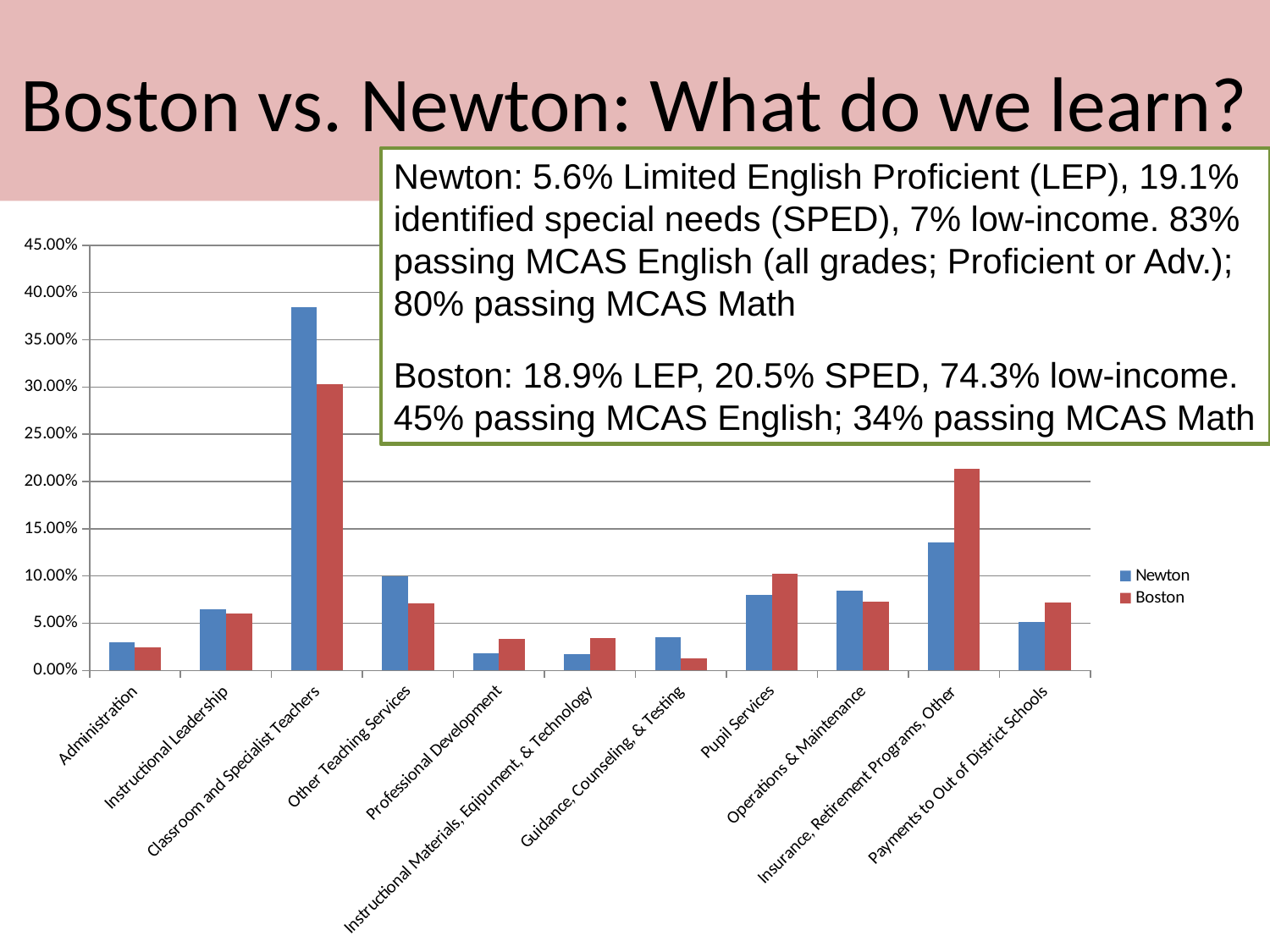
Is the Boston value for Insurance, Retirement Programs, Other greater or less than 20.00%? greater Which category has the lowest value for Boston? Guidance, Counseling, & Testing Which category has the highest value for Newton? Classroom and Specialist Teachers For Insurance, Retirement Programs, Other, which is larger: Newton or Boston? Boston Which category has the highest value for Boston? Classroom and Specialist Teachers How many spending categories are shown on the x axis? 11 What kind of chart is shown on the slide? bar chart Which series is shown in red in the legend? Boston How many series does the legend list? 2 Is the Newton value for Other Teaching Services greater or less than 15.00%? less For Classroom and Specialist Teachers, which is larger: Newton or Boston? Newton Is the Newton value for Classroom and Specialist Teachers greater or less than 35.00%? greater